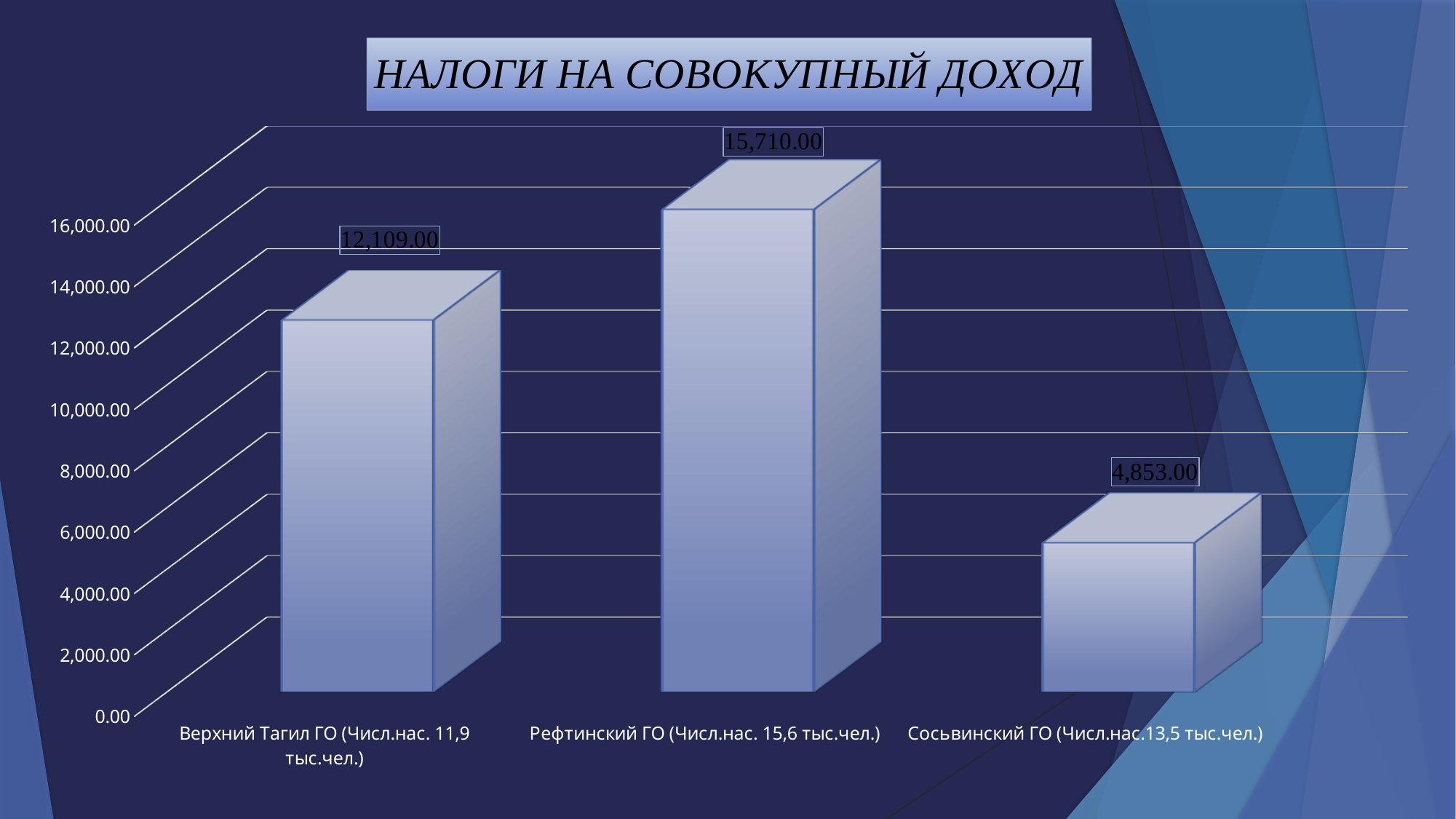
What is the title of the chart? НАЛОГИ НА СОВОКУПНЫЙ ДОХОД Which is larger, the value for Верхний Тагил ГО or the value for Сосьвинский ГО? Верхний Тагил ГО What is the value for Верхний Тагил ГО? 12,109.00 What is the value for Рефтинский ГО? 15,710.00 Which category has the highest value? Рефтинский ГО What is the value for Сосьвинский ГО? 4,853.00 Which category has the lowest value? Сосьвинский ГО What is the difference between the values for Верхний Тагил ГО and Сосьвинский ГО? 7,256.00 What kind of chart is shown on the slide? bar chart What is the difference between the values for Рефтинский ГО and Верхний Тагил ГО? 3,601.00 How many categories are shown on the chart? 3 Is the value for Сосьвинский ГО greater or less than 6,000.00? less